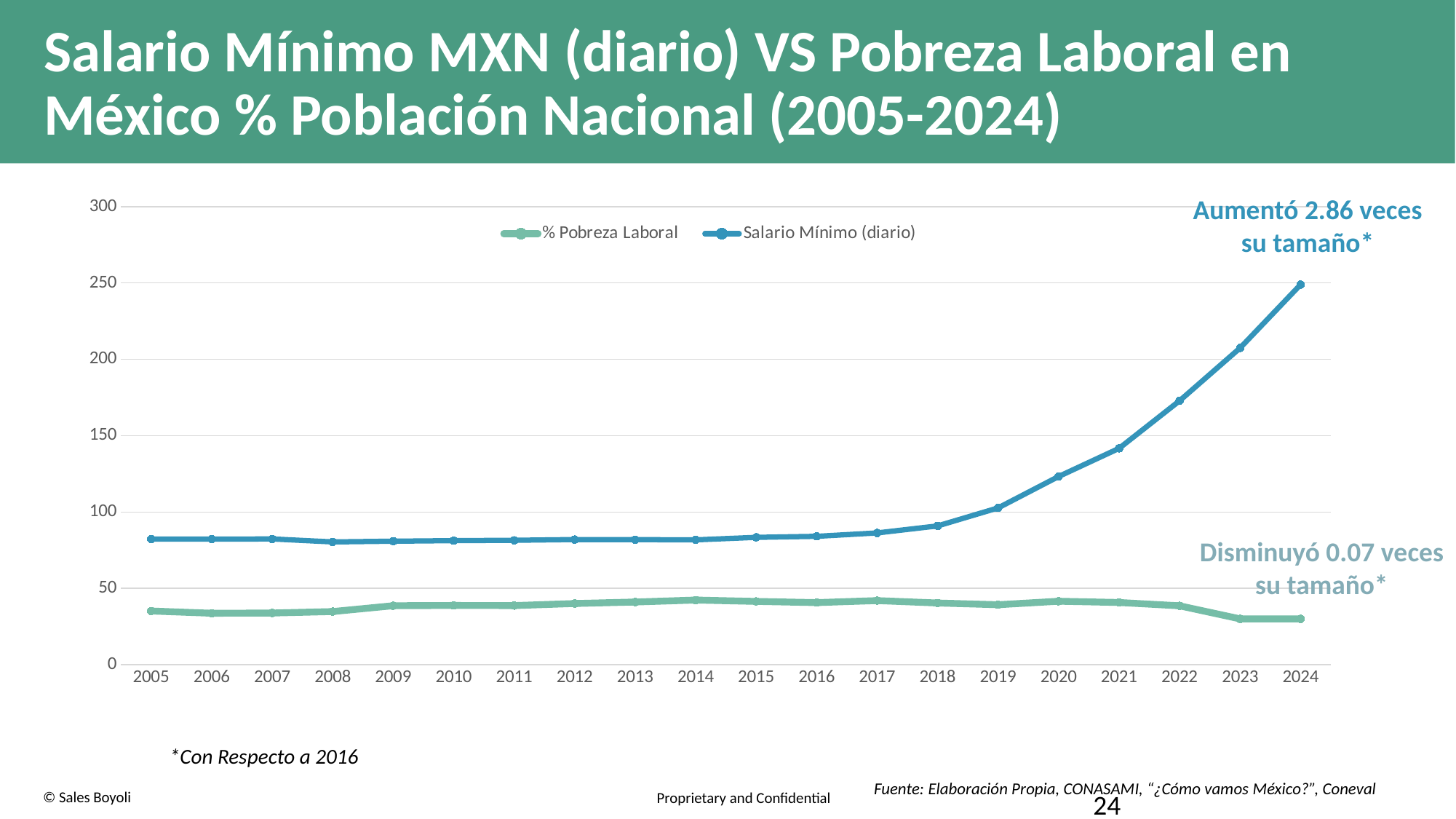
How many years are plotted along the x axis? 20 Is the value for Salario Mínimo (diario) in 2021 greater or less than 150? less Which year has the highest value for Salario Mínimo (diario)? 2024 Which series has the larger value in 2016, % Pobreza Laboral or Salario Mínimo (diario)? Salario Mínimo (diario) What kind of chart is shown on the slide? line chart Does the Salario Mínimo (diario) series rise or fall from 2016 to 2024? rise Is the value for Salario Mínimo (diario) in 2005 greater or less than 100? less Does the % Pobreza Laboral series rise or fall from 2021 to 2024? fall Is the value for Salario Mínimo (diario) in 2024 greater or less than 200? greater According to the annotation on the chart, by how many times did the Salario Mínimo increase in size? 2.86 veces How many series does the legend list? 2